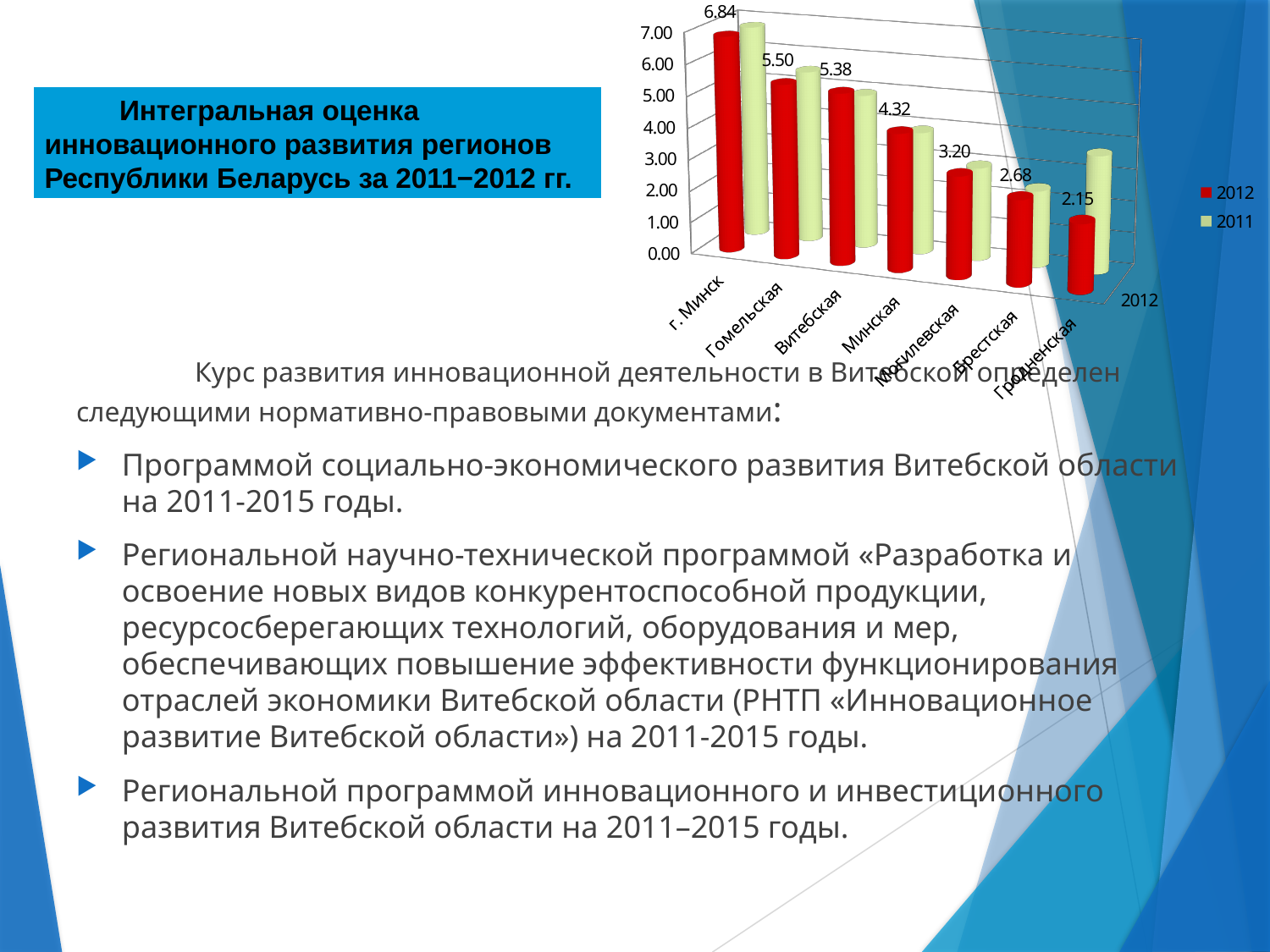
What is the 2012 value for г. Минск? 6.84 What is the 2012 value for Брестская? 2.68 What is the 2012 value for Минская? 4.32 Which region has the lowest 2012 value? Гродненская What is the difference between the 2012 values for г. Минск and Гомельская? 1.34 How many regions are shown on the x axis? 7 What kind of chart is shown on the slide? Bar chart What is the 2012 value for Гомельская? 5.50 Which is larger, the 2012 value for Минская or for Могилевская? Минская Which region has the highest 2012 value? г. Минск How many series does the legend list? 2 What is the 2012 value for Витебская? 5.38